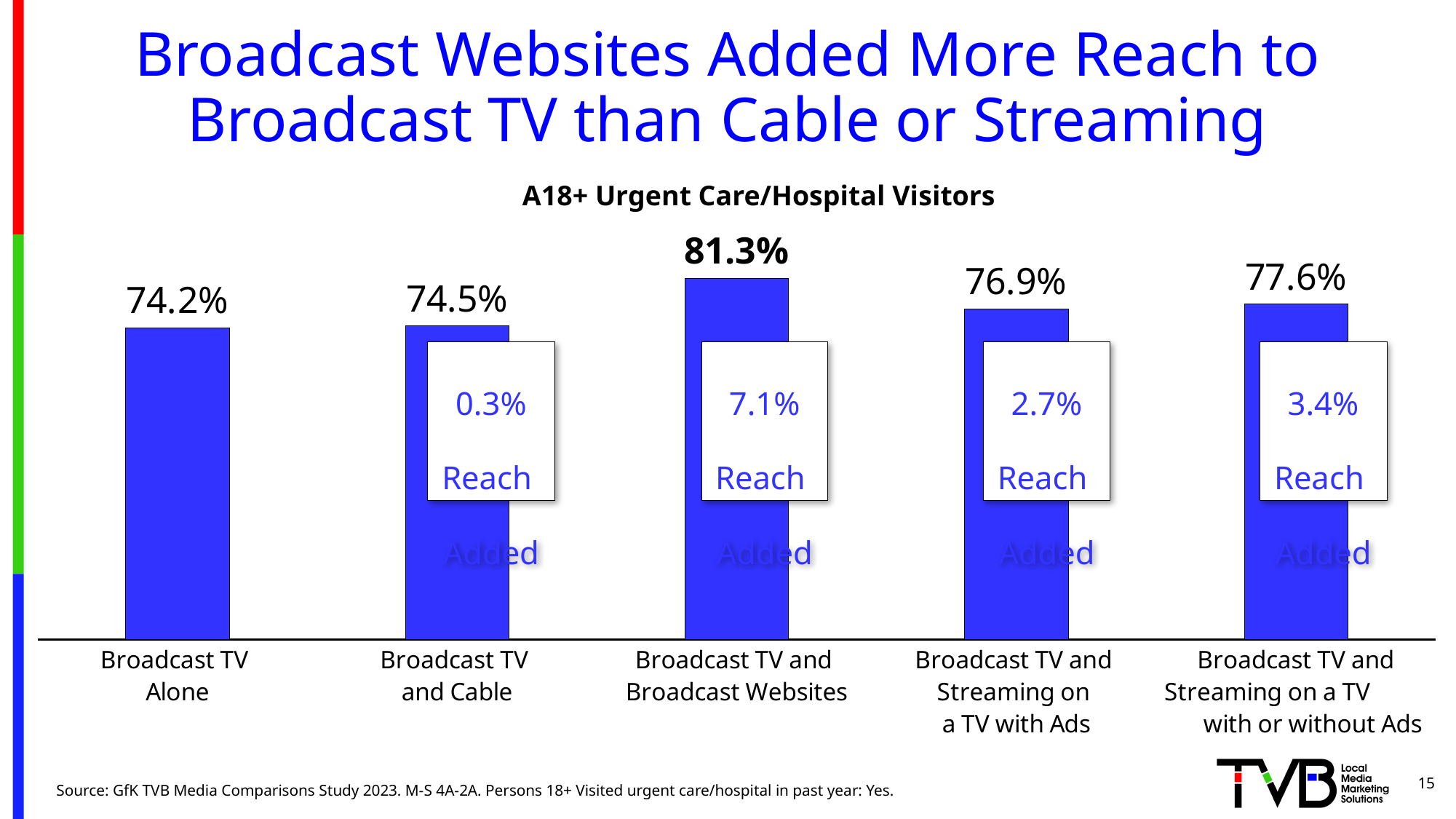
What is the reach value for Broadcast TV and Broadcast Websites? 81.3% What is the difference in reach between Broadcast TV and Broadcast Websites and Broadcast TV Alone? 7.1% What is the reach value for Broadcast TV Alone? 74.2% Which category has the lowest reach? Broadcast TV Alone How many categories are shown in the chart? 5 Which category has the highest reach? Broadcast TV and Broadcast Websites What is the subtitle of the chart describing the audience? A18+ Urgent Care/Hospital Visitors What is the difference in reach between Broadcast TV and Cable and Broadcast TV Alone? 0.3% What is the reach value for Broadcast TV and Streaming on a TV with Ads? 76.9% What is the reach value for Broadcast TV and Streaming on a TV with or without Ads? 77.6% Which has a higher reach: Broadcast TV and Streaming on a TV with Ads or Broadcast TV and Broadcast Websites? Broadcast TV and Broadcast Websites What kind of chart is shown on the slide? Bar chart